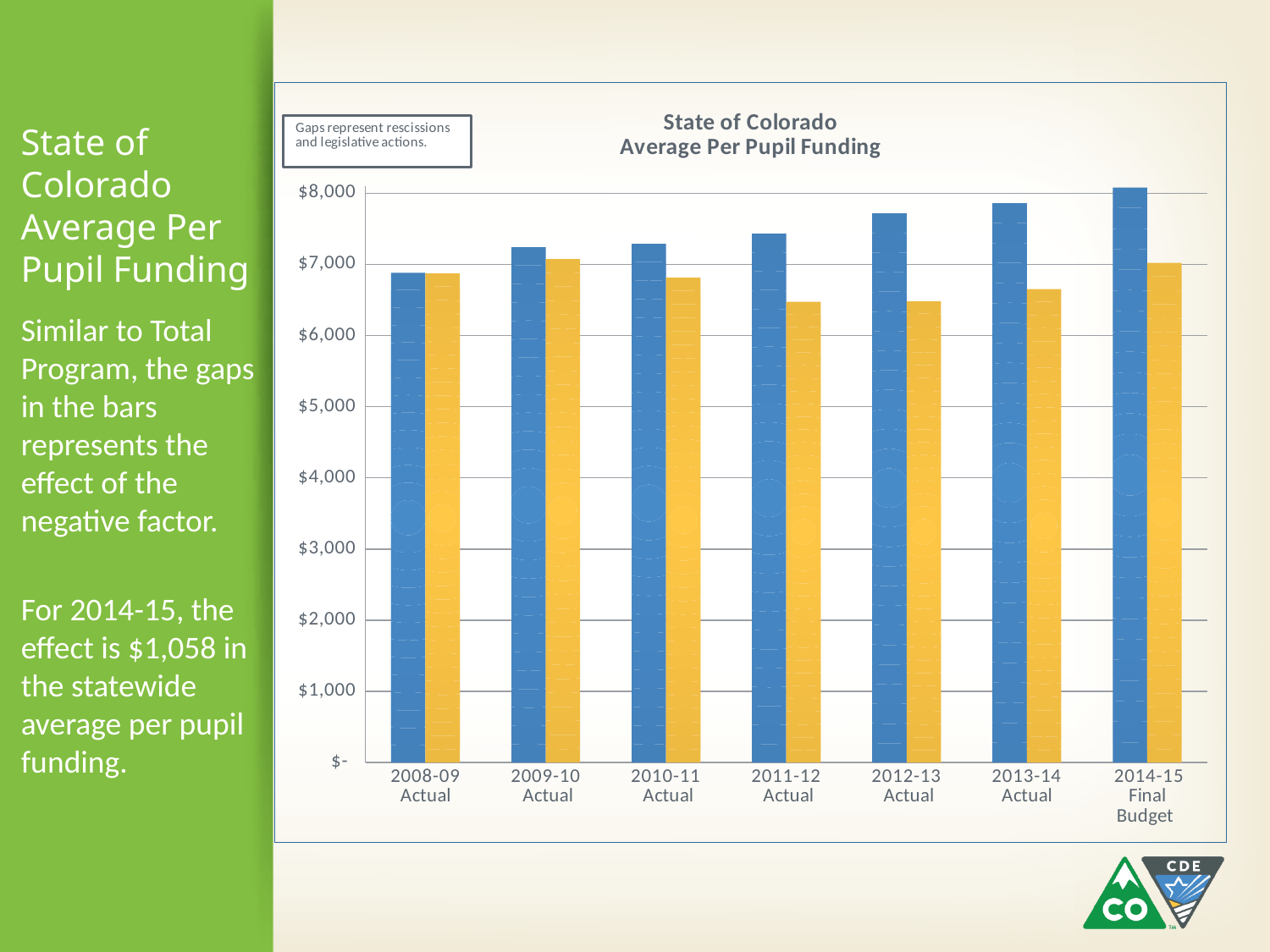
For 2013-14 Actual, which bar is taller, the blue bar or the yellow bar? The blue bar Is the blue bar for 2014-15 Final Budget greater or less than $8,000? greater Which fiscal year has the shortest blue bar? 2008-09 Actual How many bars are plotted for each fiscal year in the chart? 2 Is the blue bar for 2012-13 Actual greater or less than $7,000? greater According to the note box on the chart, what do the gaps represent? Rescissions and legislative actions Which fiscal year has the tallest blue bar? 2014-15 Final Budget How many fiscal-year categories are shown on the x axis of the chart? 7 What kind of chart is shown on the slide? Bar chart Is the yellow bar for 2011-12 Actual greater or less than $7,000? less Do the blue bars rise or fall from 2008-09 to 2014-15? Rise What is the title of the chart? State of Colorado Average Per Pupil Funding